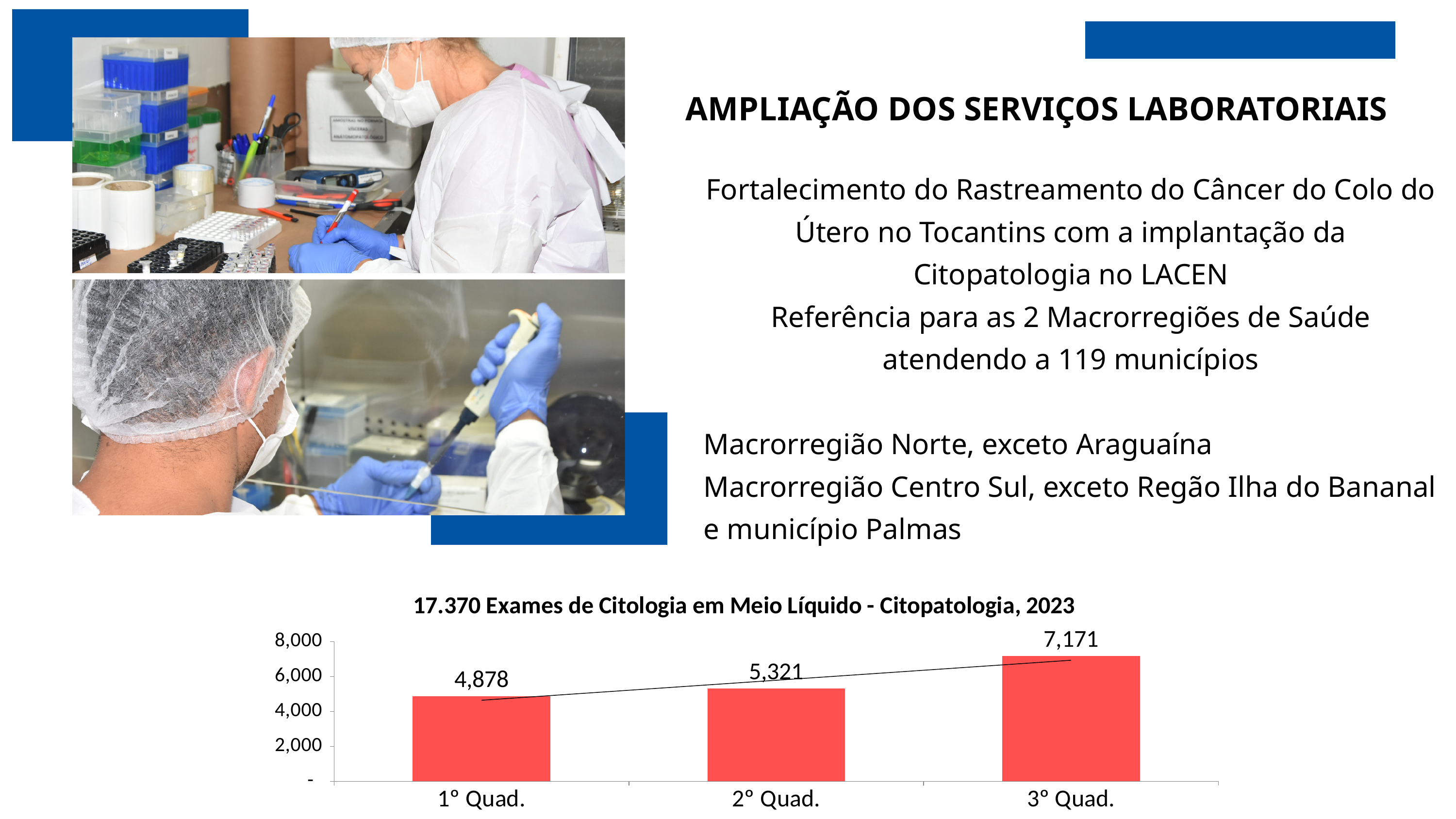
Do the values rise or fall from 1° Quad. to 3° Quad.? rise What kind of chart is shown on the slide? bar chart Which is larger, the value for 2° Quad. or the value for 3° Quad.? 3° Quad. Which category has the highest value? 3° Quad. Is the value for 3° Quad. greater or less than 6,000? greater How many categories are shown on the x axis? 3 What is the difference between the values for 2° Quad. and 1° Quad.? 443 What is the difference between the values for 3° Quad. and 1° Quad.? 2,293 What is the value for 3° Quad.? 7,171 What is the value for 1° Quad.? 4,878 Which category has the lowest value? 1° Quad. What is the value for 2° Quad.? 5,321